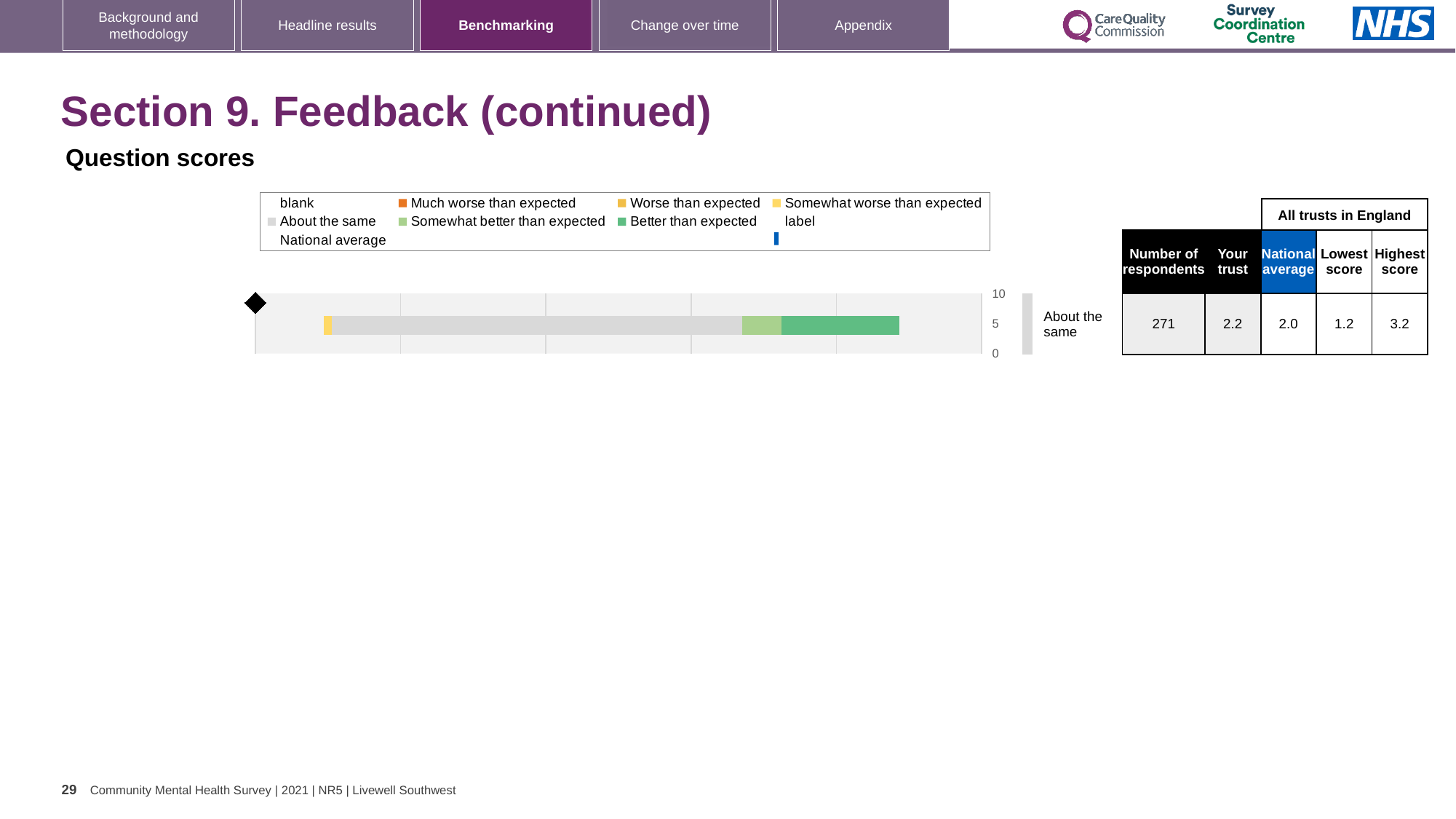
What is the highest score among all trusts in England shown in the table? 3.2 What colour does the legend use for "Better than expected"? green What is the difference between the highest score and the lowest score in the table? 2.0 What is the lowest score among all trusts in England shown in the table? 1.2 How many respondents are shown in the table for this question? 271 How many bars are plotted in the chart? 1 What is the "Your trust" score shown for the question in the table? 2.2 Which is larger, the "Your trust" score or the national average? Your trust What kind of chart is shown on the slide? bar chart What is the difference between the "Your trust" score and the national average? 0.2 What is the national average score shown in the table? 2.0 What benchmark label is shown next to the bar in the chart? About the same